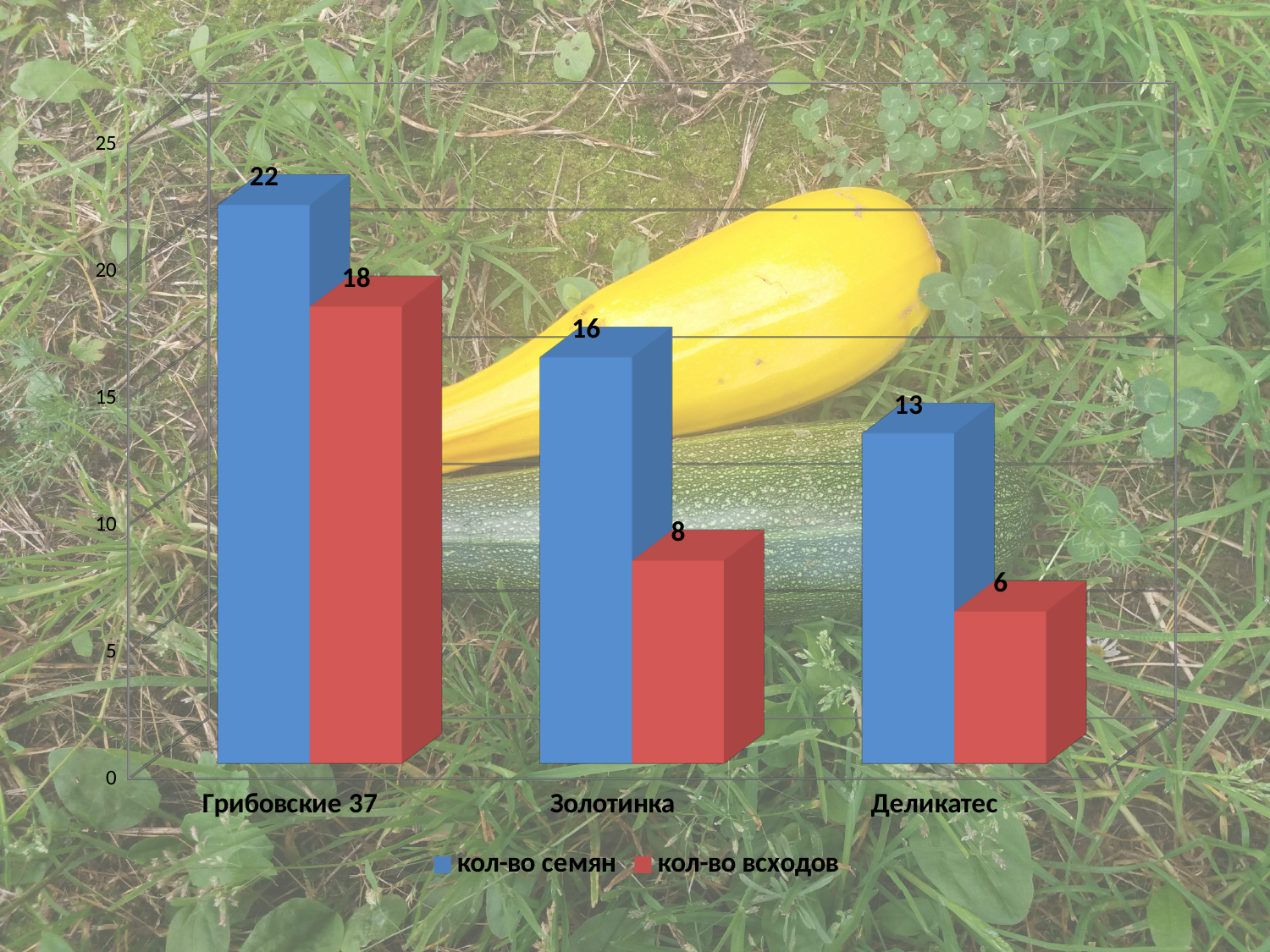
What is the value of кол-во всходов for Деликатес? 6 What is the value of кол-во всходов for Золотинка? 8 What is the difference between кол-во семян for Грибовские 37 and for Деликатес? 9 Which category has the highest value for кол-во семян? Грибовские 37 Which is larger: кол-во всходов for Грибовские 37 or кол-во семян for Золотинка? кол-во всходов for Грибовские 37 How many categories are shown on the x axis? 3 Which category has the lowest value for кол-во всходов? Деликатес What is the difference between кол-во семян and кол-во всходов for Золотинка? 8 What kind of chart is shown on the slide? bar chart Do the values for кол-во семян rise or fall from left to right along the x axis? fall What is the value of кол-во семян for Грибовские 37? 22 How many series does the legend list? 2